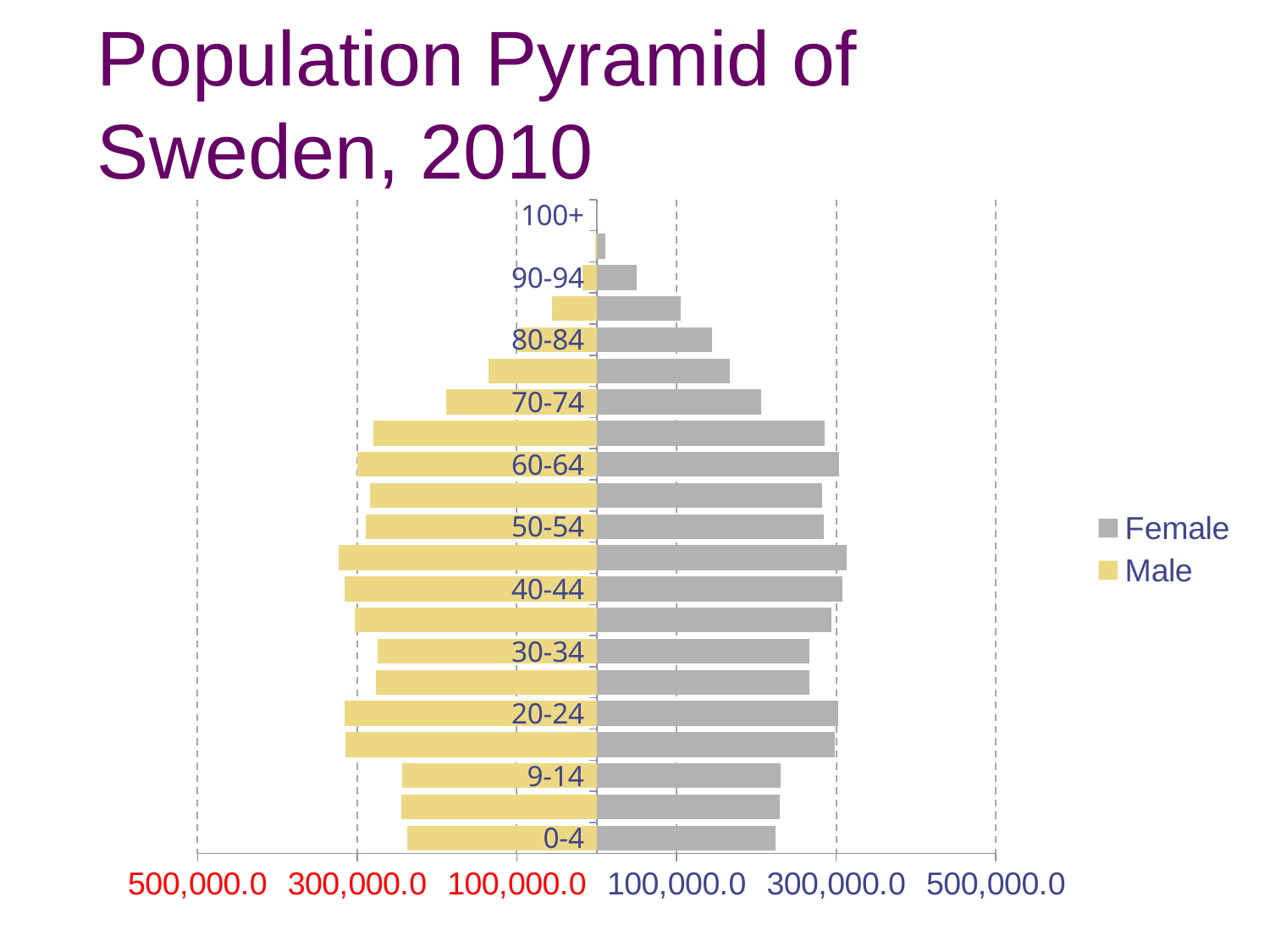
How many series does the legend list? 2 What are the two series named in the legend? Female and Male Is the Female value for the 90-94 age group greater or less than 100,000.0? less What kind of chart is shown on the slide? bar chart Moving from the 60-64 age group up to the 100+ age group, do the Female bars get longer or shorter? shorter Is the Female value for the 80-84 age group greater or less than 100,000.0? greater For the 90-94 age group, which is larger, the Female value or the Male value? Female Which colour represents the Male series? yellow Is the Male value for the 70-74 age group greater or less than 100,000.0? greater Which age group has the smallest Female value? 100+